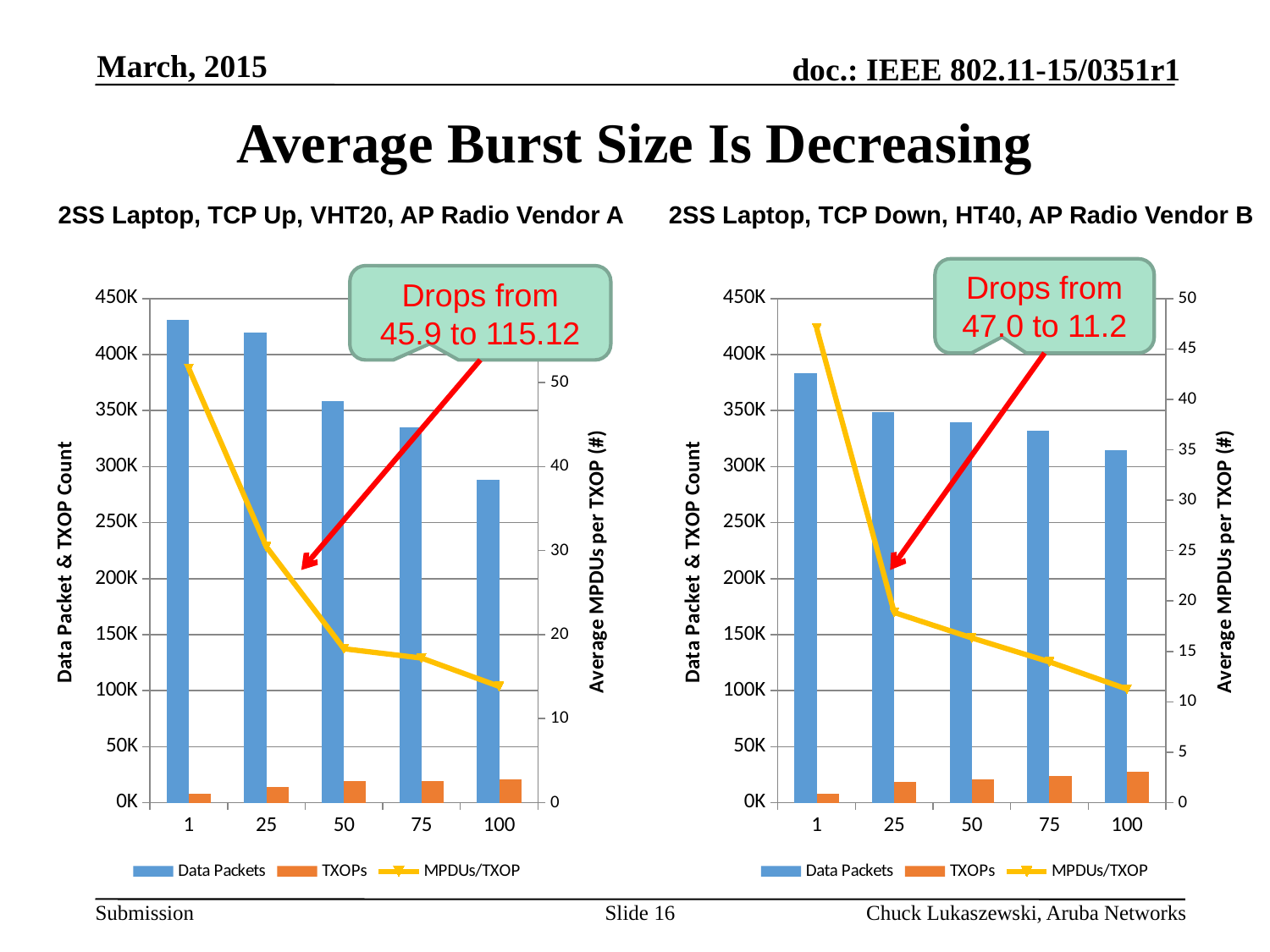
In the right chart (TCP Down, HT40, Vendor B), is the Data Packets value for category 1 larger or smaller than the Data Packets value for category 100? larger In the left chart (TCP Up, VHT20, Vendor A), which category has the lowest Data Packets bar? 100 In the right chart (TCP Down, HT40, Vendor B), is the MPDUs/TXOP value for category 100 greater or less than 15? less In the left chart (TCP Up, VHT20, Vendor A), is the Data Packets value for category 1 greater or less than 400K? greater In the right chart (2SS Laptop, TCP Down, HT40, AP Radio Vendor B), how many categories are shown on the x axis? 5 In the left chart (2SS Laptop, TCP Up, VHT20, AP Radio Vendor A), how many series does the legend list? 3 What kind of chart is the left chart (TCP Up, VHT20, Vendor A)? Combination bar and line chart In the right chart (TCP Down, HT40, Vendor B), which category has the highest TXOPs bar? 100 In the right chart (TCP Down, HT40, Vendor B), is the Data Packets value for category 1 greater or less than 400K? less In the left chart (TCP Up, VHT20, Vendor A), does the MPDUs/TXOP line rise or fall as the x-axis values increase from 1 to 100? fall In the left chart (TCP Up, VHT20, Vendor A), which category has the highest Data Packets bar? 1